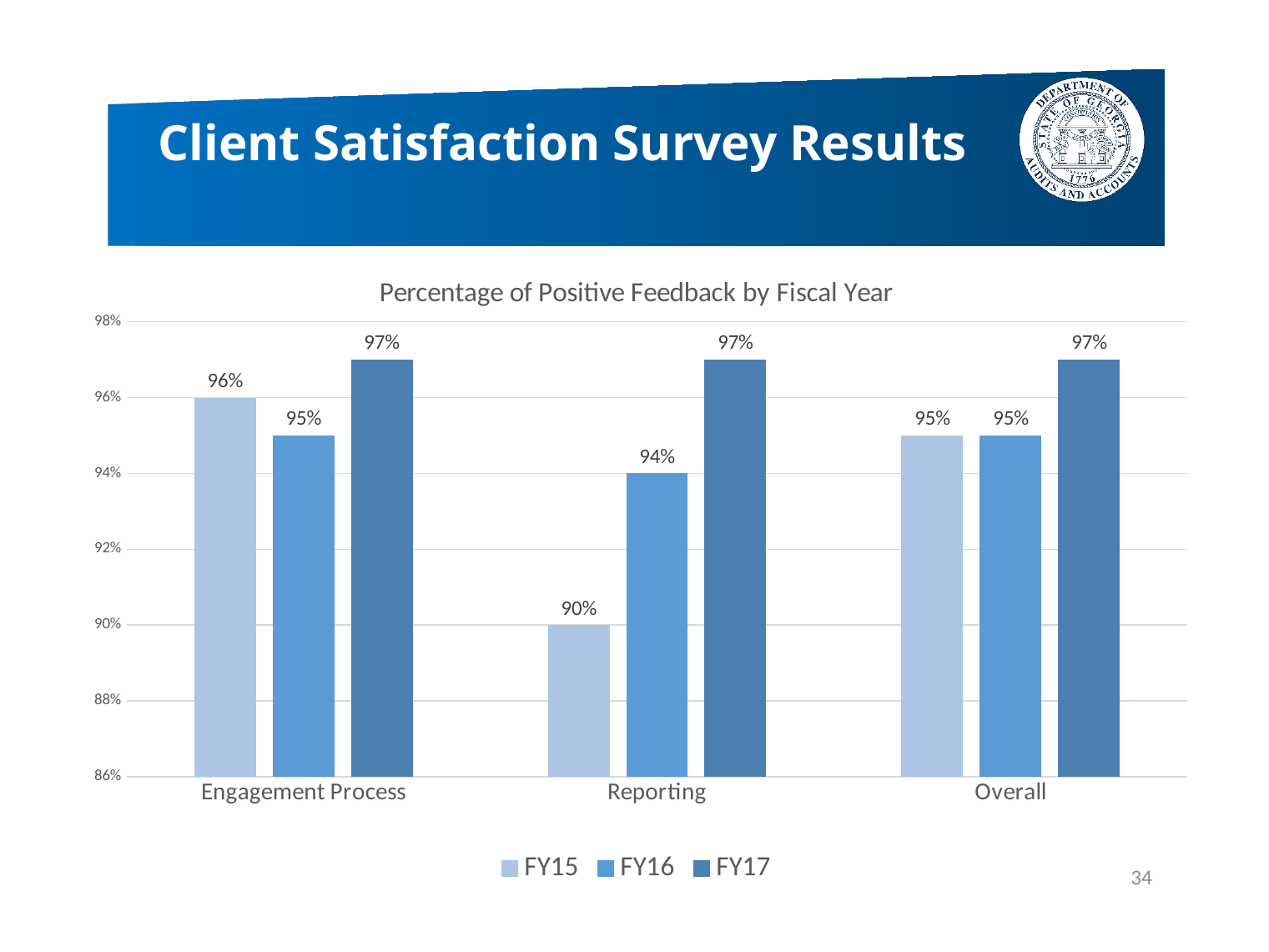
What is the difference between the FY17 and FY15 values for Reporting? 7% Which is larger for Engagement Process, the FY15 value or the FY16 value? FY15 What is the FY15 value for Reporting? 90% Which category has the lowest FY15 value? Reporting How many series does the legend list? 3 Is the FY15 value for Reporting greater or less than 92%? less What kind of chart is shown on the slide? bar chart What is the FY17 value for Overall? 97% What is the title of the chart? Percentage of Positive Feedback by Fiscal Year What is the FY16 value for Engagement Process? 95% Which category has the highest FY16 value? Engagement Process and Overall (tied at 95%) How many categories are shown on the x axis? 3